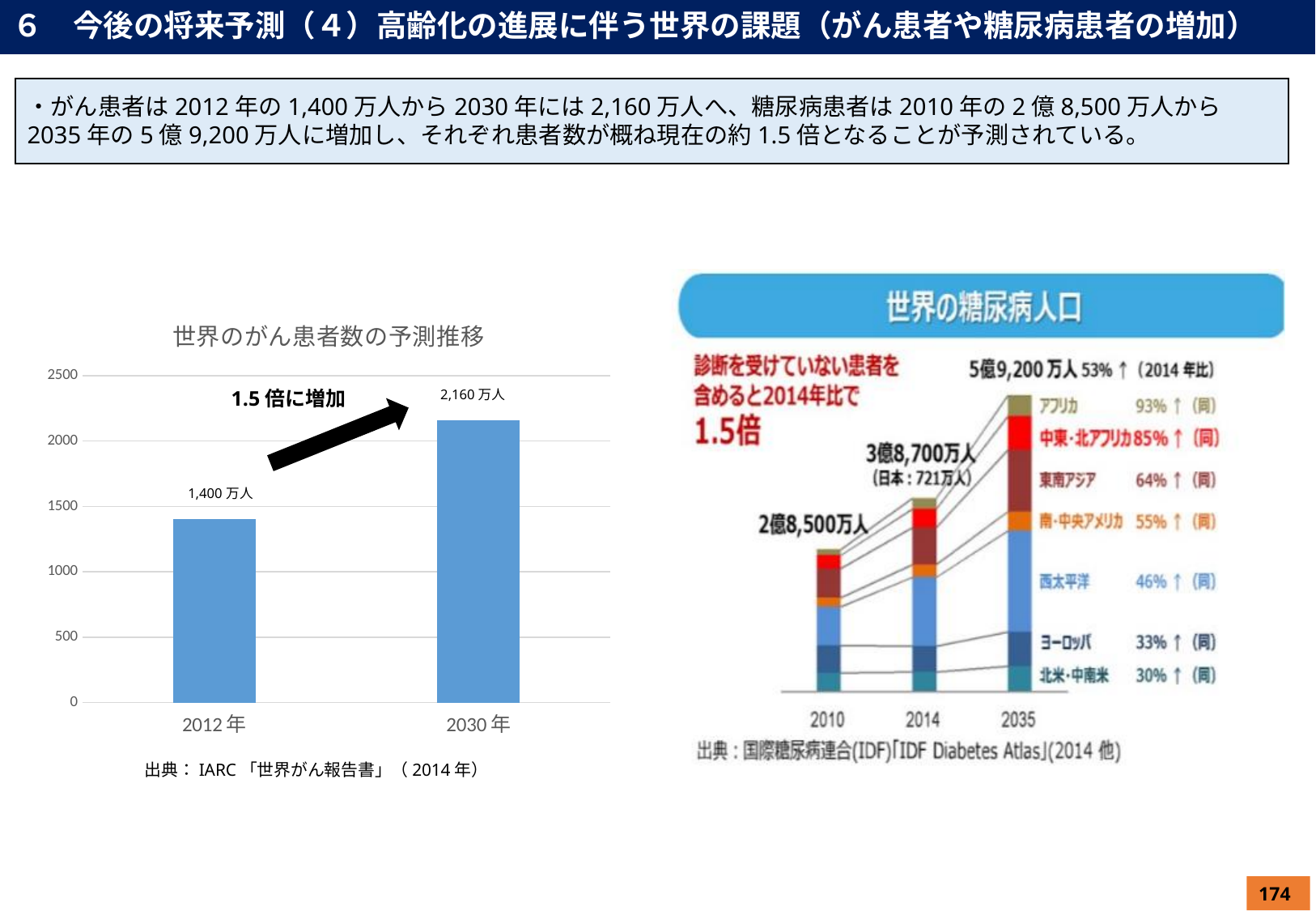
「世界の糖尿病人口」のグラフで、2010年の合計はいくつですか？ 2億8,500万人 「世界のがん患者数の予測推移」のグラフで、2030年と2012年の差はいくつですか？ 760万人 「世界のがん患者数の予測推移」のグラフは何種類のグラフですか？ 棒グラフ 「世界の糖尿病人口」のグラフで、2014年の合計はいくつですか？ 3億8,700万人 「世界のがん患者数の予測推移」のグラフで、2012年の値はいくつですか？ 1,400万人 「世界のがん患者数の予測推移」のグラフで、2012年の値は1500より大きいですか、小さいですか？ 小さい 「世界のがん患者数の予測推移」のグラフで、2030年の値はいくつですか？ 2,160万人 「世界のがん患者数の予測推移」のグラフで、2012年から2030年にかけて値は増加していますか、減少していますか？ 増加 「世界の糖尿病人口」のグラフで、2035年の合計はいくつですか？ 5億9,200万人 「世界のがん患者数の予測推移」のグラフには、いくつの年（カテゴリ）が示されていますか？ 2 「世界の糖尿病人口」のグラフで、アフリカの増加率（2014年比）は何％ですか？ 93% 「世界の糖尿病人口」のグラフで、2014年の日本の糖尿病人口はいくつですか？ 721万人